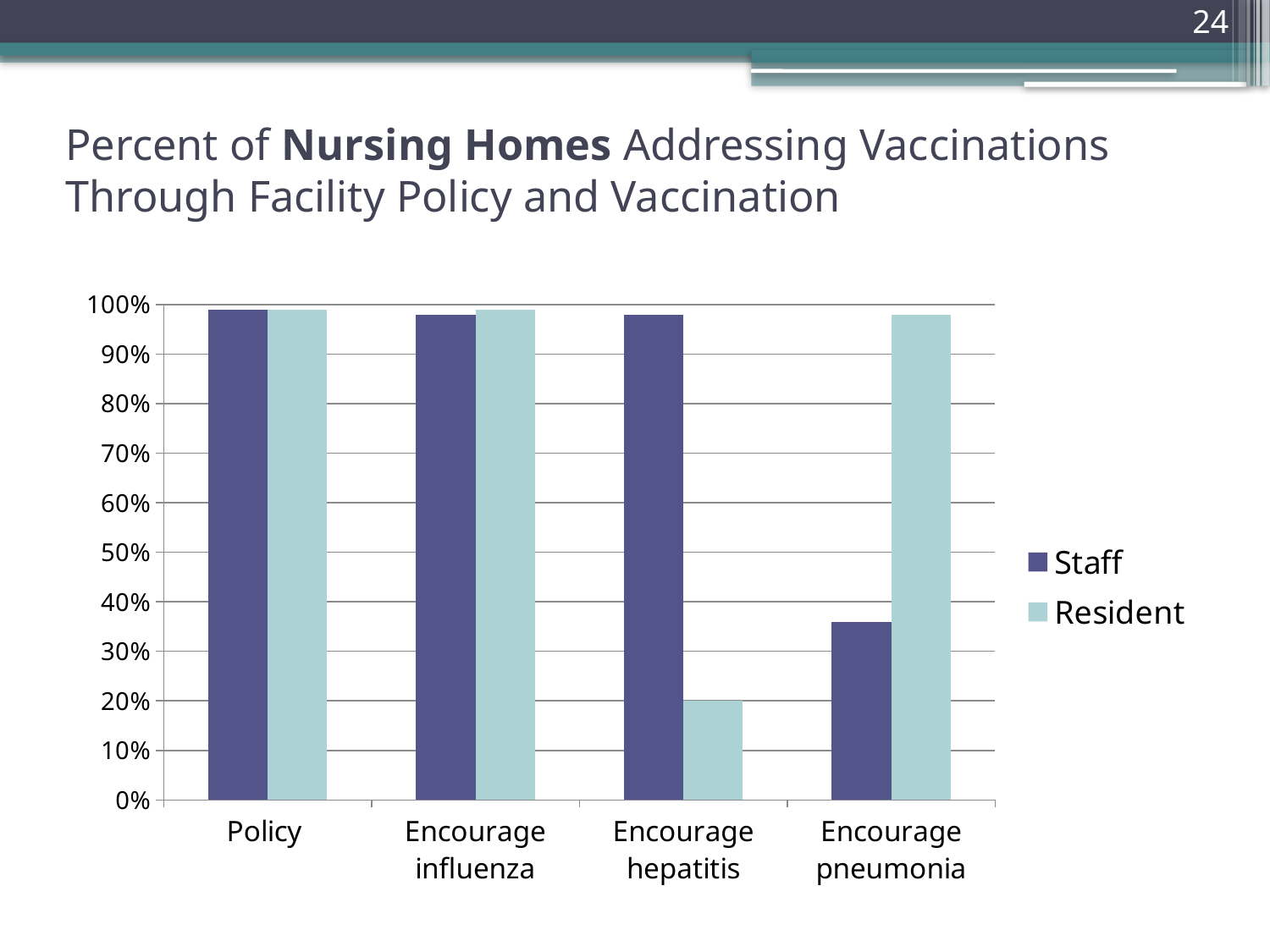
What kind of chart is shown on the slide? bar chart How many categories are shown on the x axis? 4 How many series does the legend list? 2 Is the Staff value for Encourage pneumonia greater or less than 50%? less Which category has the lowest Resident value? Encourage hepatitis Is the Resident value for Encourage pneumonia greater or less than 90%? greater Is the Resident value for Encourage hepatitis greater or less than 50%? less Which series does the legend list first? Staff For Encourage hepatitis, which is larger, the Staff value or the Resident value? Staff For Encourage pneumonia, which is larger, the Staff value or the Resident value? Resident